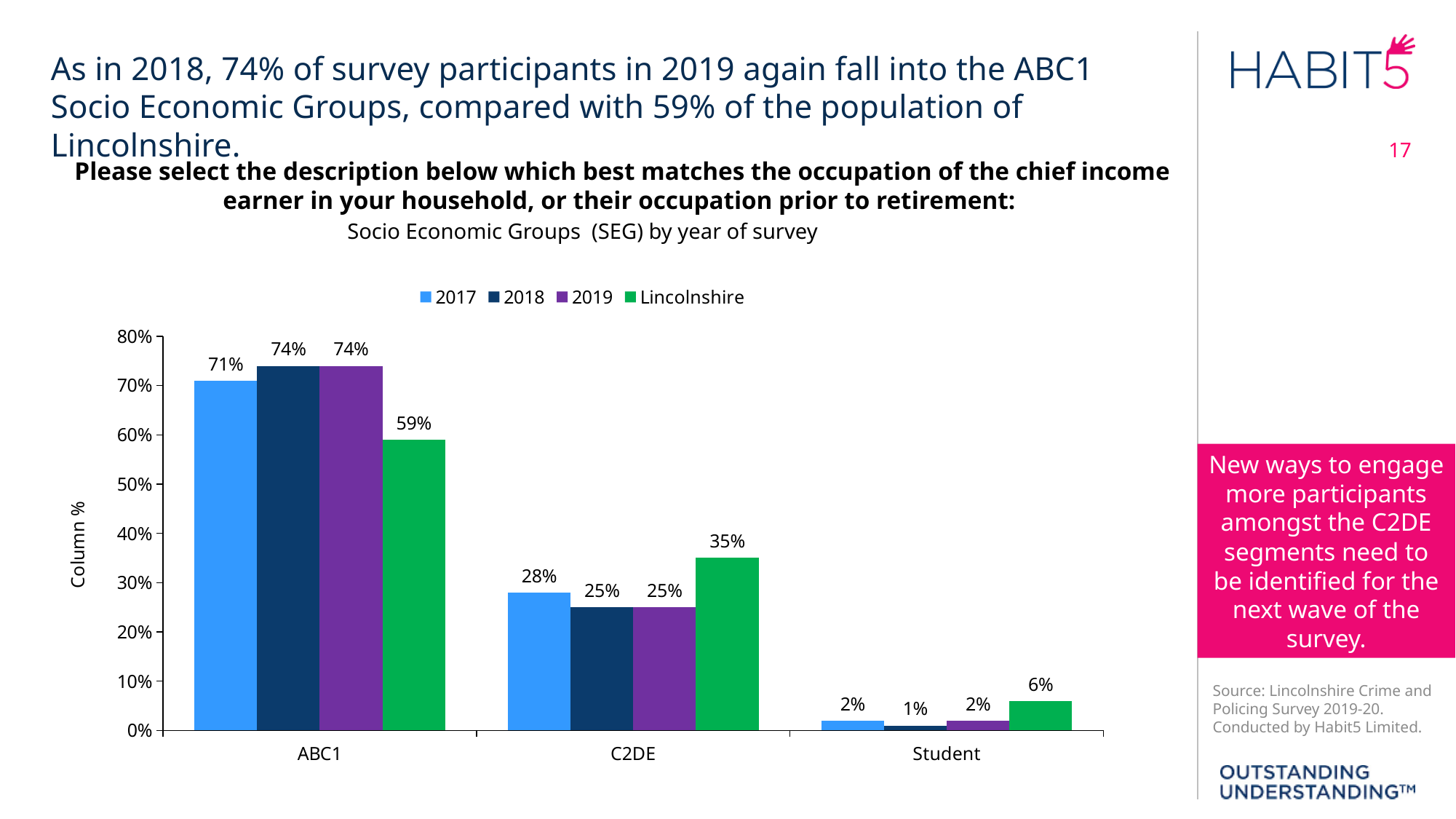
How many categories are shown on the x axis? 3 What is the value for ABC1 in the 2019 series? 74% Which category has the lowest value in the 2017 series? Student What is the label of the y axis? Column % Which category has the highest value in the Lincolnshire series? ABC1 What is the value for Student in the 2018 series? 1% How many series does the legend list? 4 What is the difference between the 2019 value and the Lincolnshire value for ABC1? 15% What kind of chart is shown on the slide? Bar chart Which is larger for C2DE: the 2017 value or the Lincolnshire value? Lincolnshire What is the value for C2DE in the Lincolnshire series? 35% What is the value for C2DE in the 2017 series? 28%